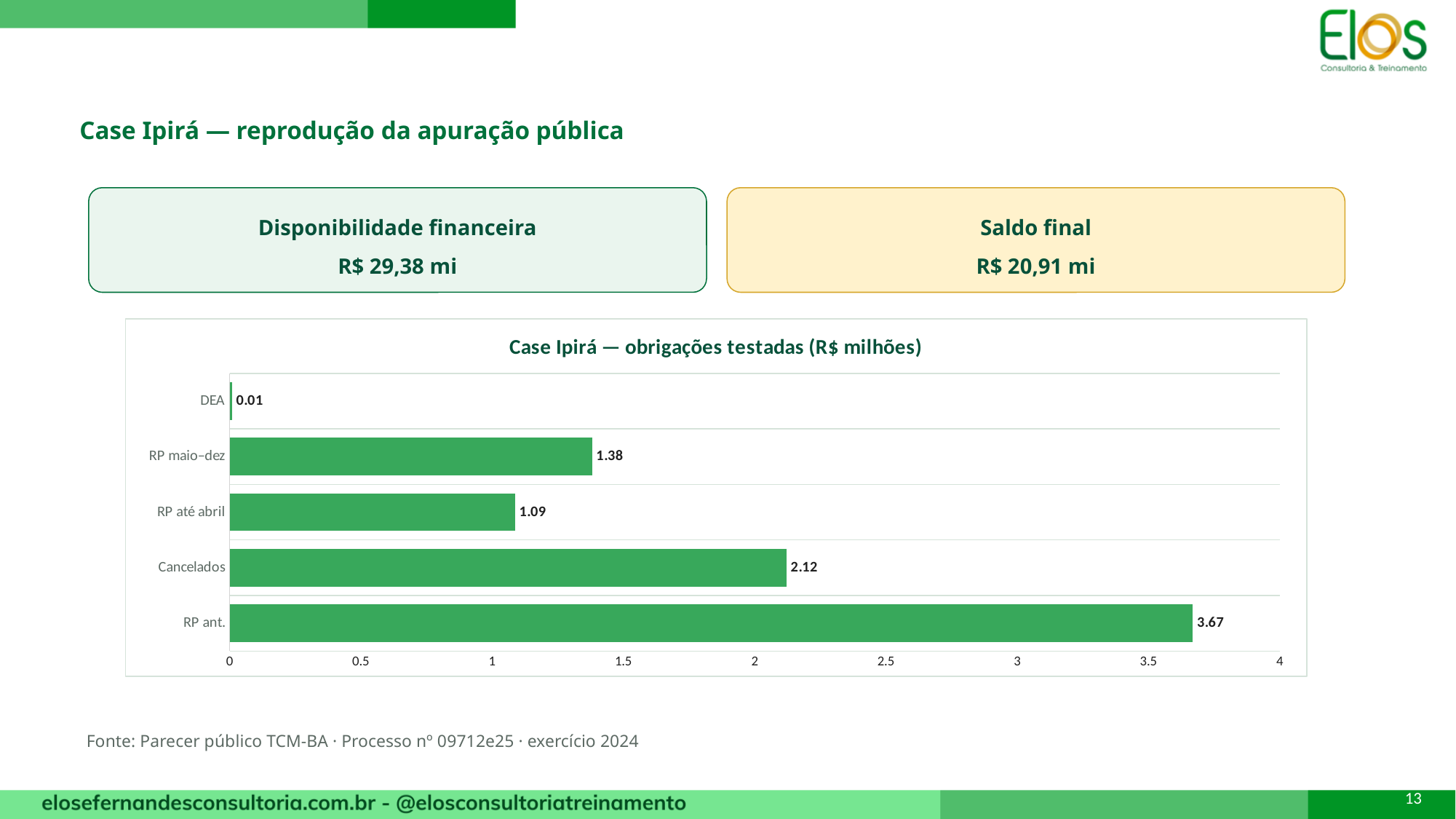
What is the title of the chart? Case Ipirá — obrigações testadas (R$ milhões) What is the value for RP maio–dez? 1.38 What is the difference between the values for RP ant. and Cancelados? 1.55 How many categories are shown in the chart? 5 Is the value for Cancelados greater or less than 2? greater What is the value for RP ant.? 3.67 Which category has the highest value? RP ant. What is the value for Cancelados? 2.12 What is the value for DEA? 0.01 Which category has the lowest value? DEA Which is larger, the value for RP maio–dez or RP até abril? RP maio–dez What kind of chart is shown on the slide? bar chart